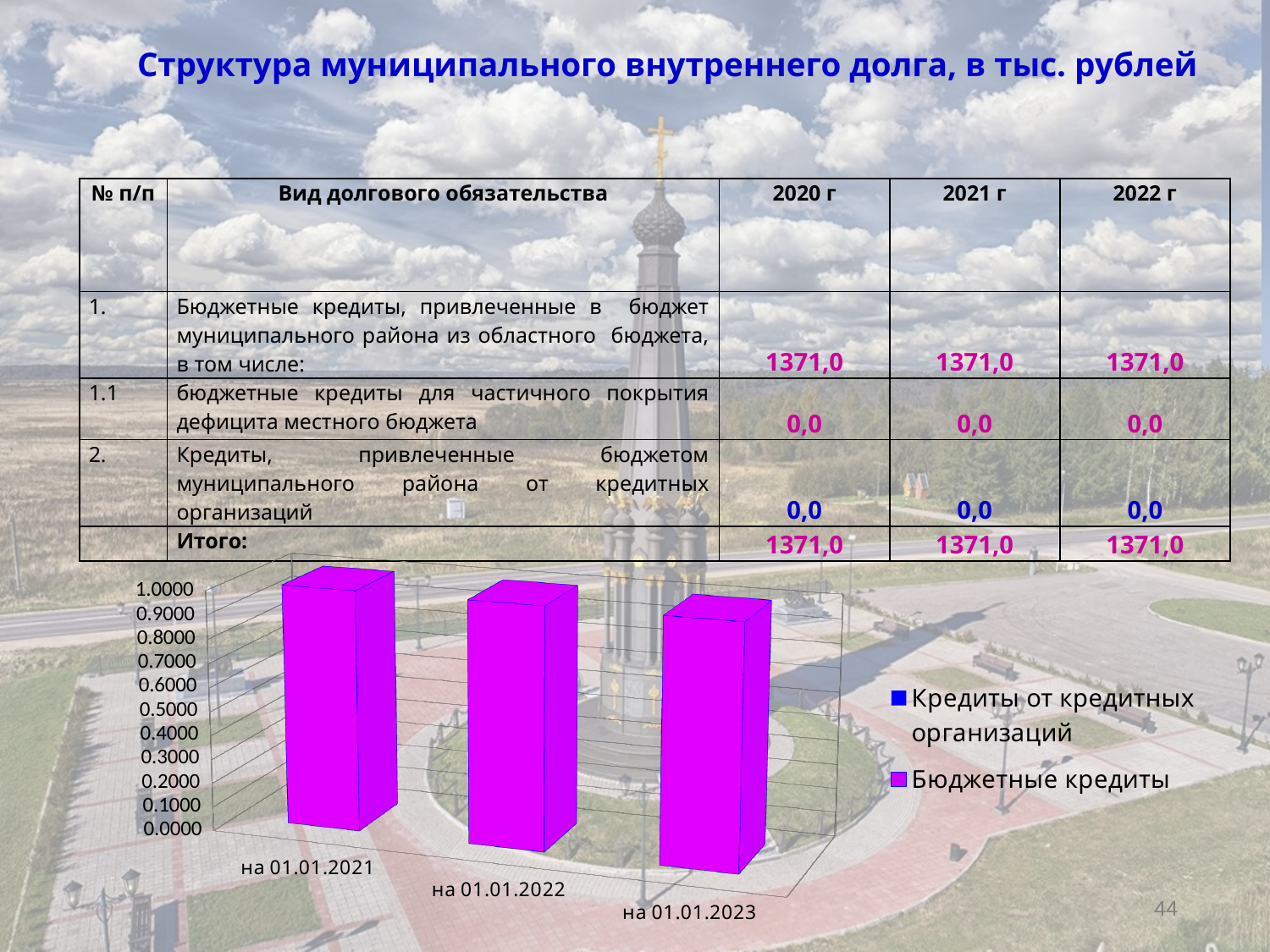
What kind of chart is shown on the slide? bar chart Is the value for на 01.01.2021 in the chart greater or less than 0.5000? greater Is the value for на 01.01.2022 in the chart greater or less than 0.5000? greater Is the value for на 01.01.2023 in the chart greater or less than 0.3000? greater Which series are listed in the chart legend? Кредиты от кредитных организаций; Бюджетные кредиты What colour are the bars for Бюджетные кредиты in the chart? magenta What is the label of the first category on the chart's x axis? на 01.01.2021 What is the highest tick value shown on the chart's vertical axis? 1.0000 How many categories are shown on the x axis of the chart? 3 What is the label of the last category on the chart's x axis? на 01.01.2023 How many series does the chart legend list? 2